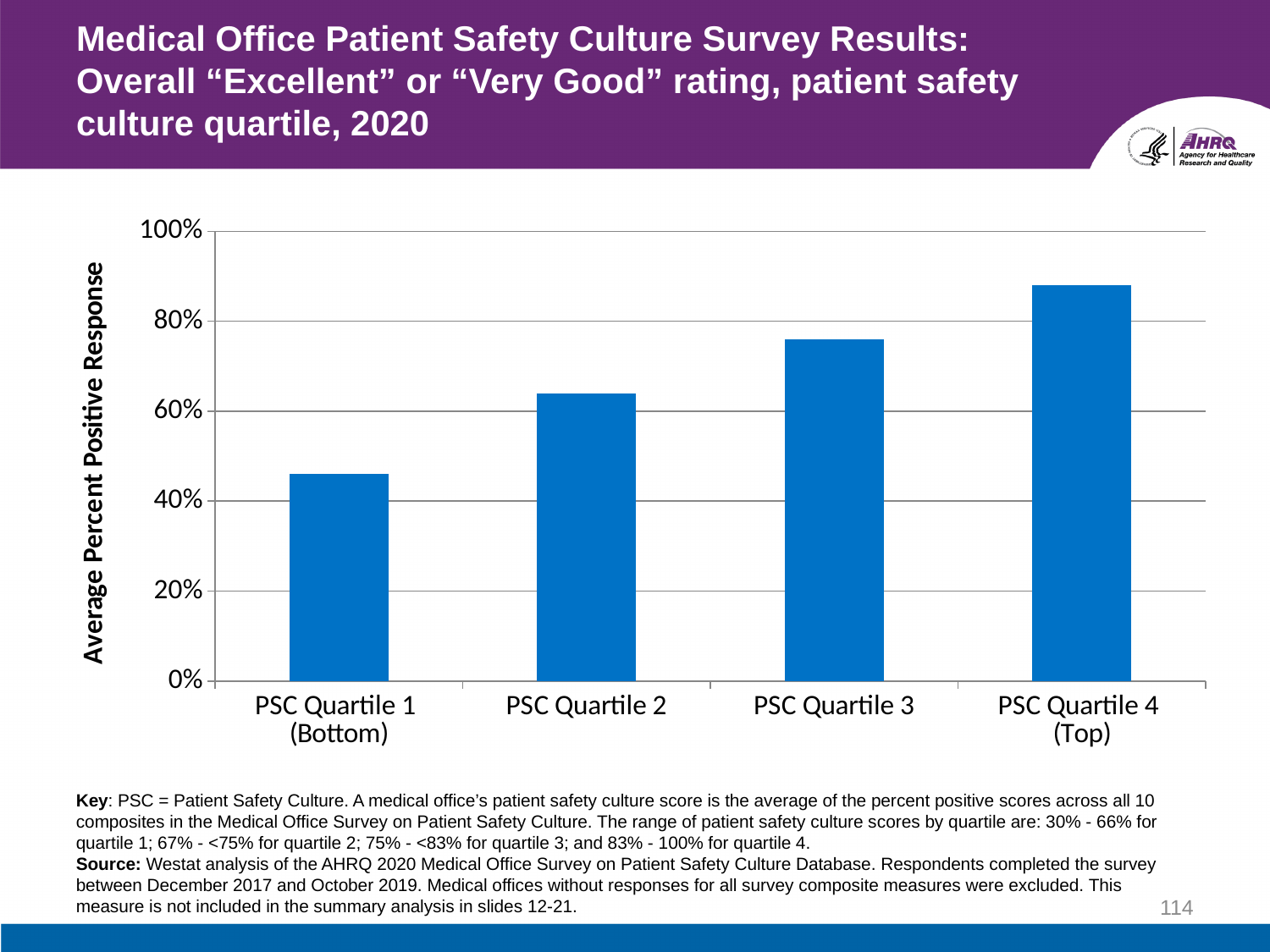
Is the value for PSC Quartile 2 greater or less than 60%? greater What kind of chart is shown on the slide? Bar chart What is the label of the vertical axis? Average Percent Positive Response Is the value for PSC Quartile 1 (Bottom) greater or less than 60%? less Which PSC quartile has the lowest average percent positive response? PSC Quartile 1 (Bottom) Do the values rise or fall from PSC Quartile 1 to PSC Quartile 4 along the x axis? Rise Is the value for PSC Quartile 1 (Bottom) greater or less than 40%? greater Which has a larger average percent positive response, PSC Quartile 2 or PSC Quartile 3? PSC Quartile 3 How many PSC quartile categories are plotted on the chart? 4 Which PSC quartile has the highest average percent positive response? PSC Quartile 4 (Top)